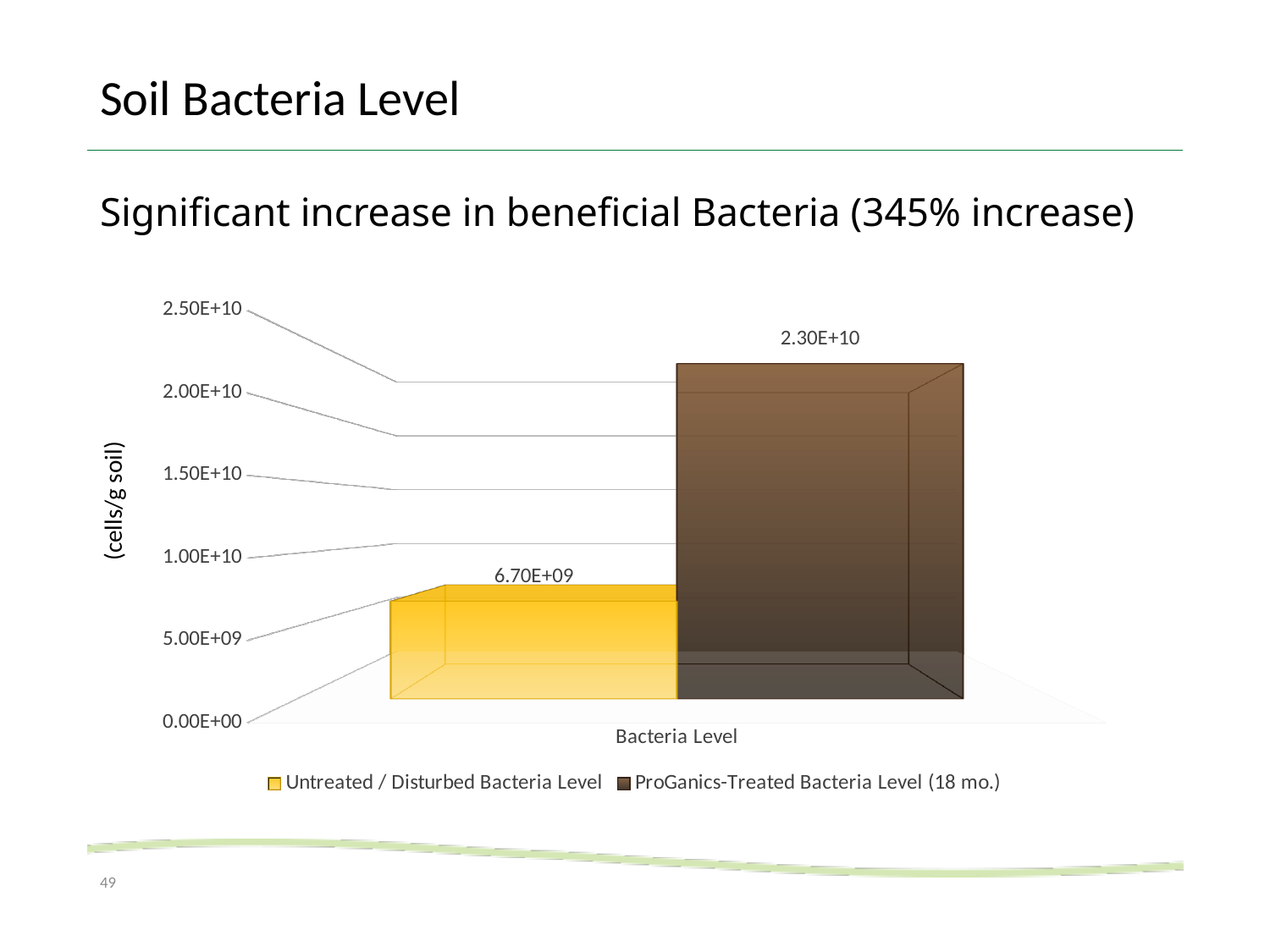
Which series has the higher bacteria level? ProGanics-Treated Bacteria Level (18 mo.) What is the label of the y axis? (cells/g soil) What is the value for Untreated / Disturbed Bacteria Level? 6.70E+09 What is the value for ProGanics-Treated Bacteria Level (18 mo.)? 2.30E+10 What kind of chart is shown on the slide? Bar chart What is the category label on the x axis? Bacteria Level Which series has the lower bacteria level? Untreated / Disturbed Bacteria Level How many categories are shown on the x axis? 1 How many series does the legend list? 2 Is the value for ProGanics-Treated Bacteria Level (18 mo.) greater or less than 2.00E+10? greater Is the value for Untreated / Disturbed Bacteria Level greater or less than 1.00E+10? less Is the ProGanics-Treated Bacteria Level (18 mo.) value larger than the Untreated / Disturbed Bacteria Level value? Yes